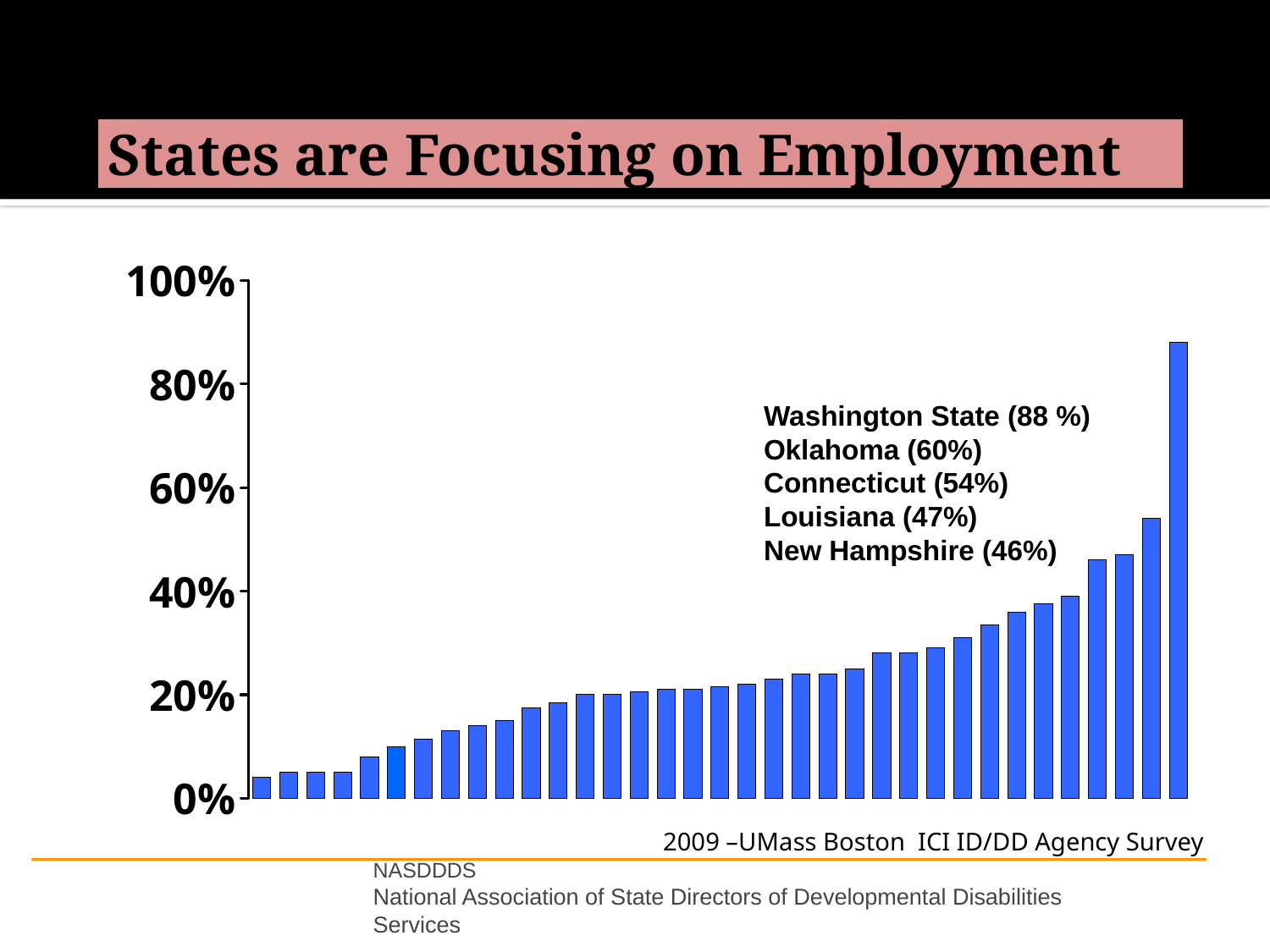
Which has the larger value, Connecticut or Louisiana? Connecticut What is the difference between the values for Washington State and Oklahoma? 28 percentage points What is the title of the slide? States are Focusing on Employment Which state has the highest value in the chart? Washington State What value is given for Connecticut in the chart annotation? 54% What value is given for Louisiana in the chart annotation? 47% What value is given for Washington State in the chart annotation? 88 % Is the value of the tallest bar greater or less than 80%? greater What kind of chart is shown on the slide? bar chart What value is given for New Hampshire in the chart annotation? 46% What value is given for Oklahoma in the chart annotation? 60% Do the bar values rise or fall from left to right along the x axis? rise